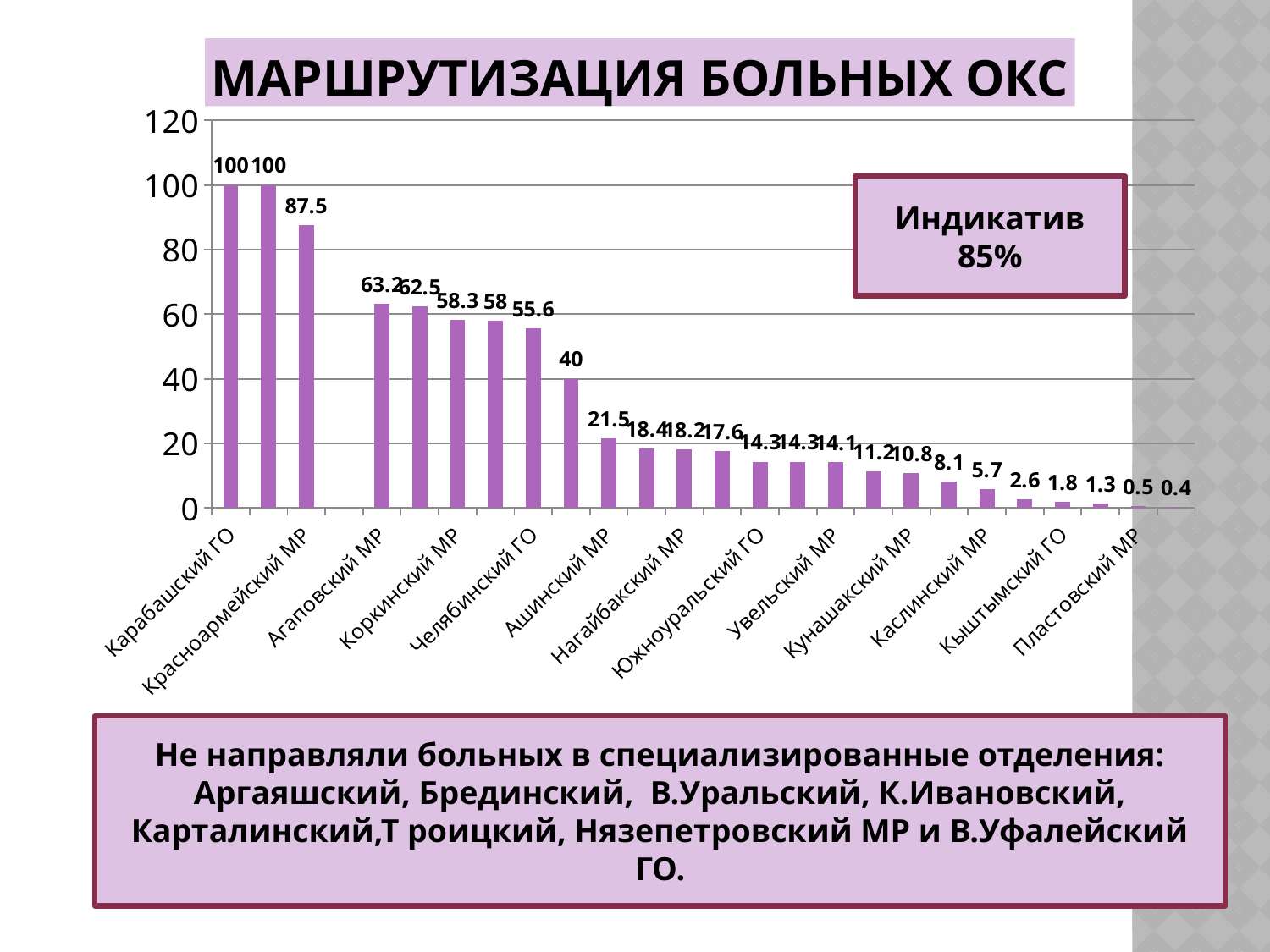
What is the value for Карабашский ГО? 100 Is the value for Кунашакский МР greater or less than 20? less What is the difference between the values for Карабашский ГО and Красноармейский МР? 12.5 What is the value for Челябинский ГО? 55.6 What is the highest value shown on the chart? 100 What kind of chart is shown on the slide? bar chart What is the lowest value shown on the chart? 0.4 What is the title of the chart? МАРШРУТИЗАЦИЯ БОЛЬНЫХ ОКС What is the value for Красноармейский МР? 87.5 What is the value for Ашинский МР? 21.5 Which has a larger value, Агаповский МР or Коркинский МР? Агаповский МР Do the values generally rise or fall from left to right along the x axis? fall